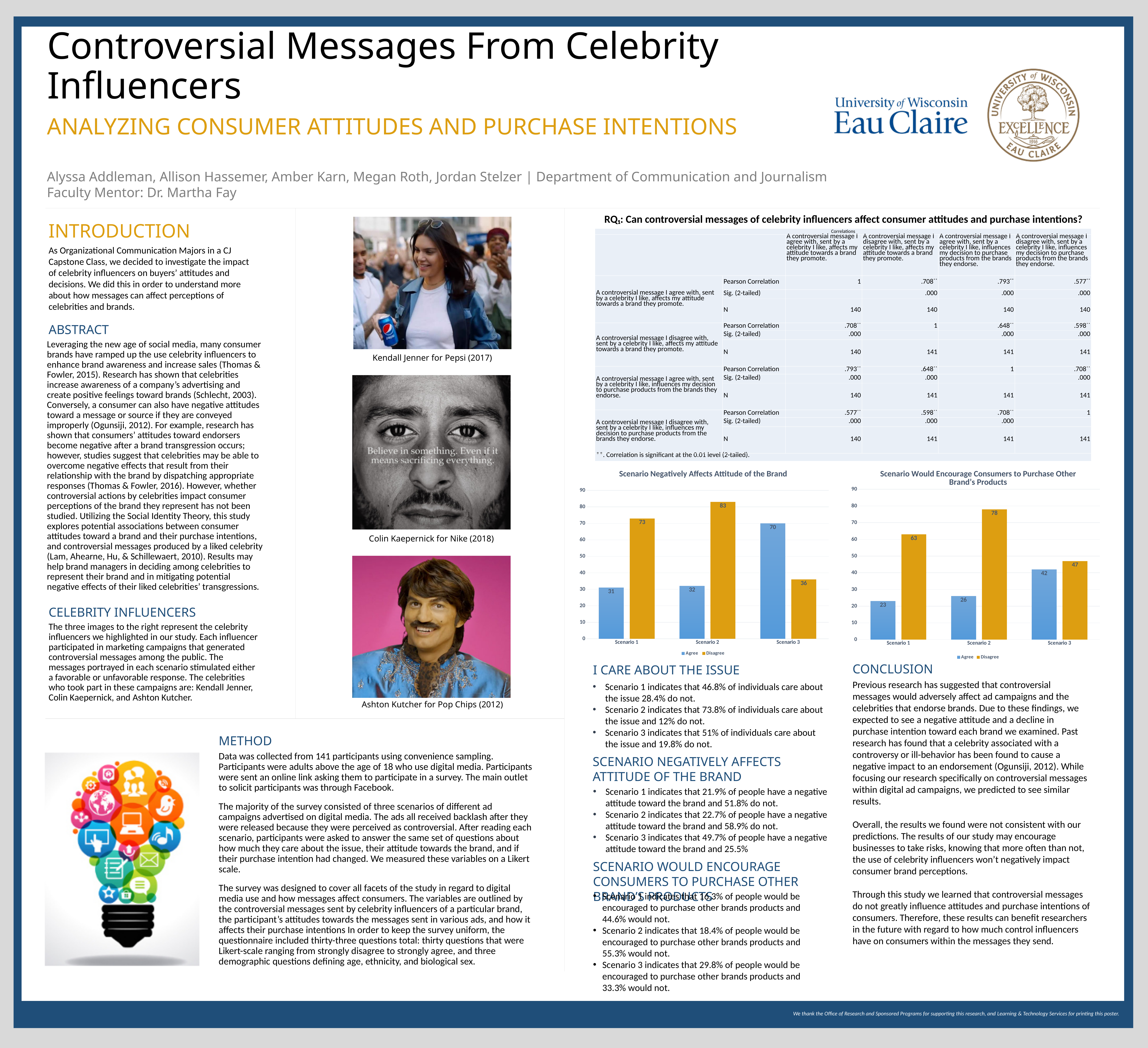
In the chart titled "Scenario Negatively Affects Attitude of the Brand", what is the difference between the Disagree and Agree values for Scenario 3? 34 In the chart titled "Scenario Negatively Affects Attitude of the Brand", what is the Disagree value for Scenario 2? 83 In the chart titled "Scenario Would Encourage Consumers to Purchase Other Brand's Products", what is the difference between the Disagree values for Scenario 2 and Scenario 1? 15 In the chart titled "Scenario Would Encourage Consumers to Purchase Other Brand's Products", which scenario has the lowest Agree value? Scenario 1 In the chart titled "Scenario Negatively Affects Attitude of the Brand", which scenario has the highest Agree value? Scenario 3 In the chart titled "Scenario Would Encourage Consumers to Purchase Other Brand's Products", what is the Disagree value for Scenario 2? 78 How many scenarios are shown on the x axis of the chart titled "Scenario Negatively Affects Attitude of the Brand"? 3 In the chart titled "Scenario Would Encourage Consumers to Purchase Other Brand's Products", is the Disagree value for Scenario 1 larger or the Agree value for Scenario 3? Disagree value for Scenario 1 What kind of chart is the chart titled "Scenario Negatively Affects Attitude of the Brand"? Bar chart In the chart titled "Scenario Negatively Affects Attitude of the Brand", what is the Agree value for Scenario 1? 31 In the chart titled "Scenario Would Encourage Consumers to Purchase Other Brand's Products", what is the Agree value for Scenario 3? 42 How many series does the legend list in the chart titled "Scenario Would Encourage Consumers to Purchase Other Brand's Products"? 2